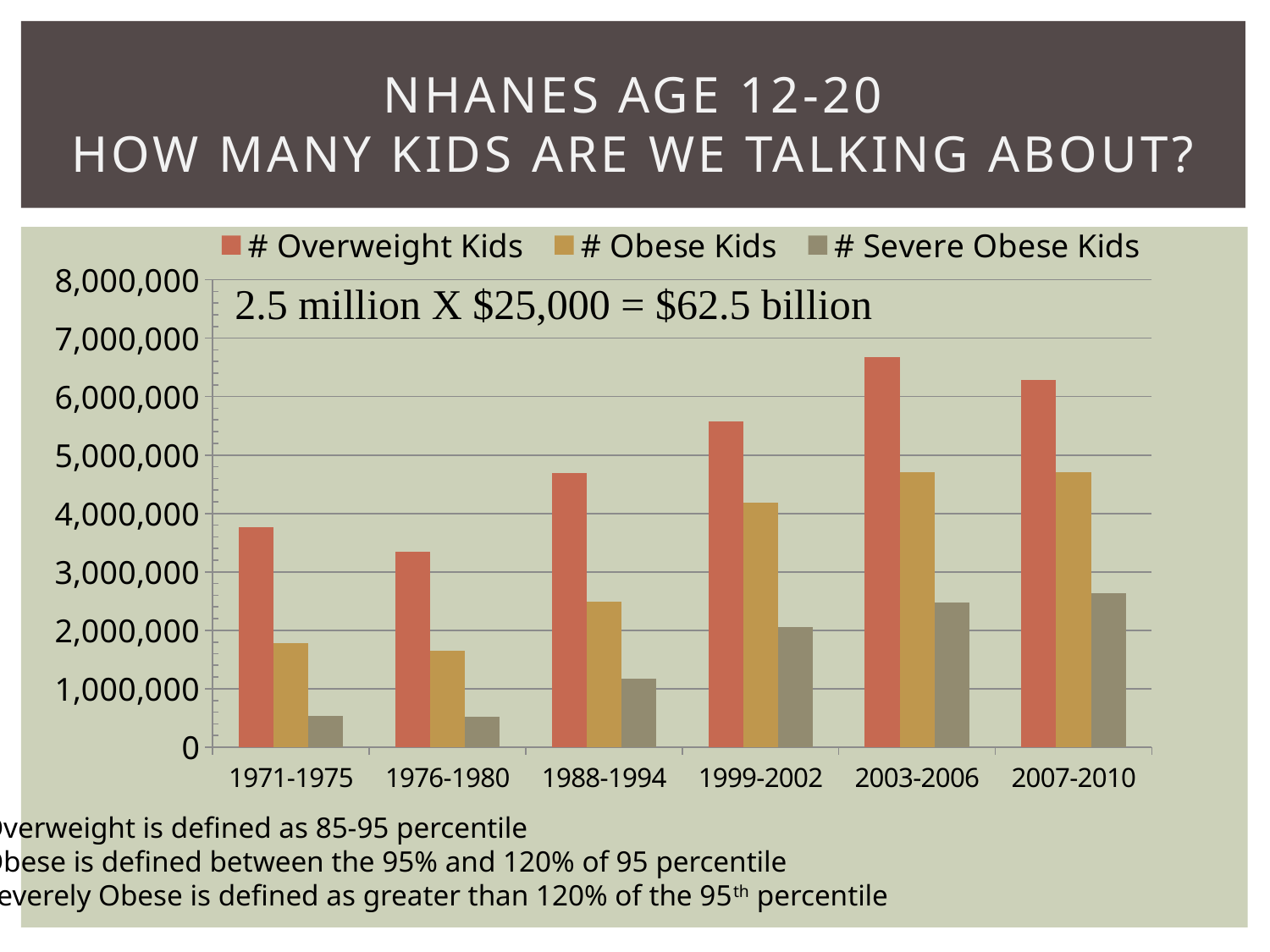
Is the number of overweight kids in 2003-2006 greater or less than 6,000,000? greater What kind of chart is shown on the slide? bar chart How many survey periods are shown on the x axis? 6 Is the number of obese kids in 1999-2002 greater or less than 4,000,000? greater How many series does the legend list? 3 Is the number of overweight kids in 1976-1980 greater or less than 4,000,000? less Which survey period has the highest number of overweight kids? 2003-2006 What calculation is written as text inside the chart area? 2.5 million X $25,000 = $62.5 billion Which survey period has the lowest number of overweight kids? 1976-1980 Does the number of severe obese kids generally rise or fall from 1971-1975 to 2007-2010? rise Which is larger: the number of overweight kids in 1999-2002 or in 2007-2010? 2007-2010